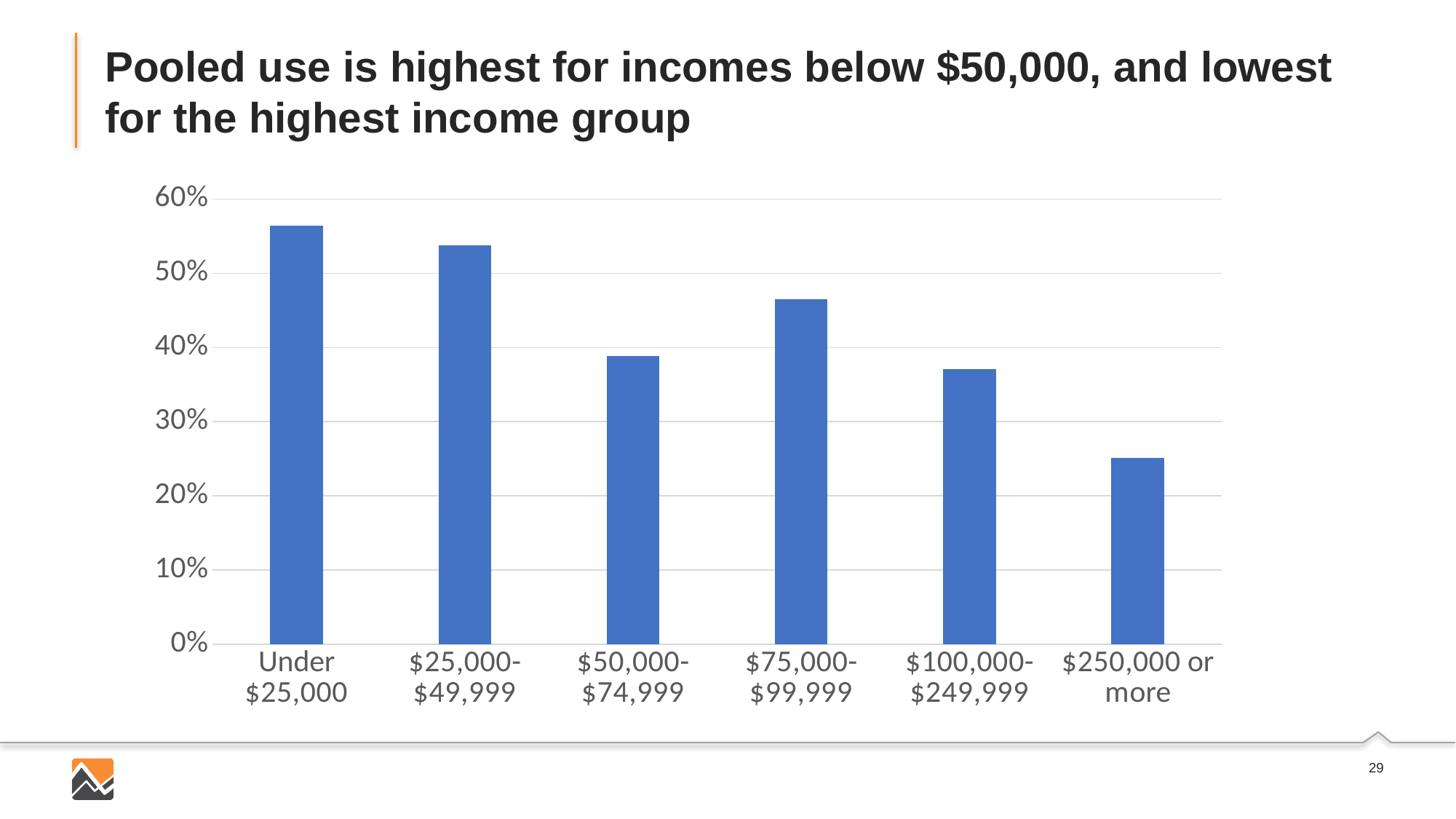
Which income group has the highest bar? Under $25,000 What is the title of the slide? Pooled use is highest for incomes below $50,000, and lowest for the highest income group Which is larger, the value for $100,000-$249,999 or the value for $250,000 or more? $100,000-$249,999 Is the value for Under $25,000 greater or less than 50%? greater Is the value for $50,000-$74,999 greater or less than 40%? less What kind of chart is shown on the slide? bar chart Which income group has the lowest bar? $250,000 or more How many income groups are shown on the x axis? 6 Is the value for $250,000 or more greater or less than 30%? less Which is larger, the value for $50,000-$74,999 or the value for $75,000-$99,999? $75,000-$99,999 What is the highest value shown on the y axis? 60%